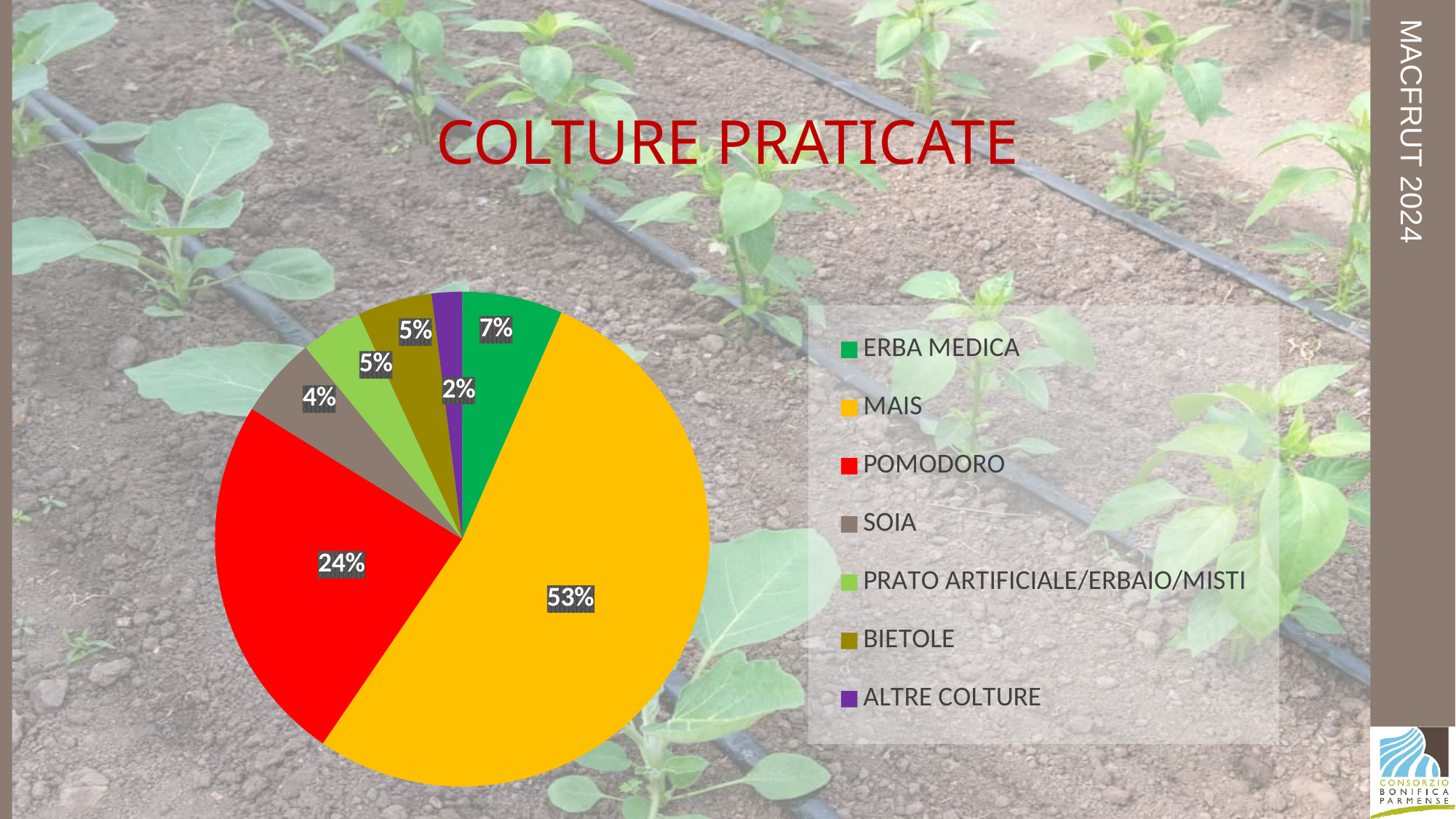
What share of the pie does ALTRE COLTURE take? 2% What kind of chart is shown on the slide? pie chart Which category has the largest slice of the pie? MAIS How many categories does the legend list? 7 What is the title of the chart? COLTURE PRATICATE What share of the pie does ERBA MEDICA take? 7% What share of the pie does POMODORO take? 24% What share of the pie does SOIA take? 4% Which category has the smallest slice of the pie? ALTRE COLTURE Which is larger, the share for ERBA MEDICA or the share for SOIA? ERBA MEDICA What share of the pie does MAIS take? 53% What is the difference in percentage points between MAIS and POMODORO? 29